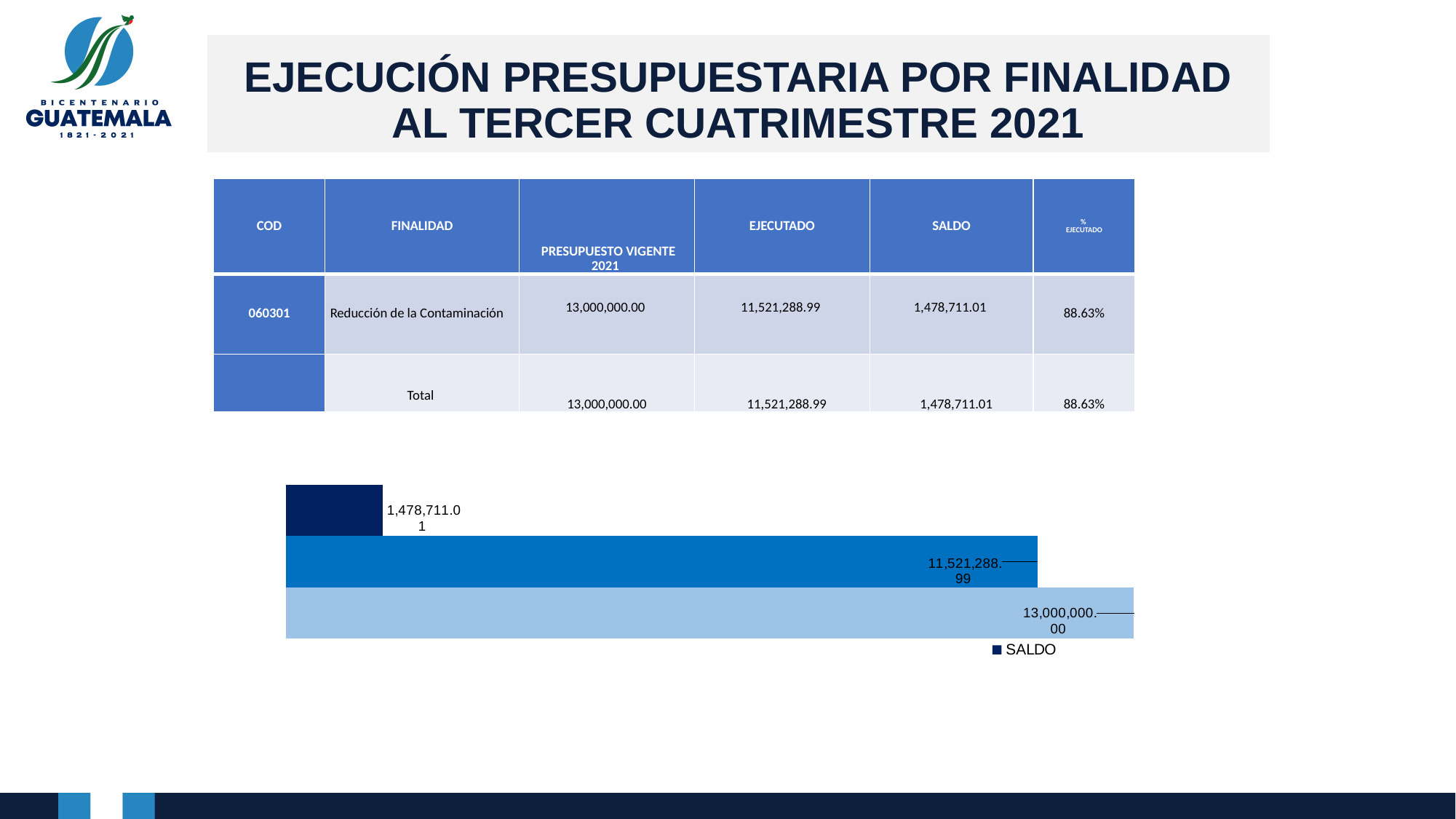
How many bars are plotted in the chart? 3 What kind of chart is shown on the slide? bar chart Which bar in the chart has the lowest value? the top (dark navy) bar, 1,478,711.01 Which bar in the chart has the highest value? the bottom (light blue) bar, 13,000,000.00 What is the difference between the bottom bar value (13,000,000.00) and the middle bar value (11,521,288.99)? 1,478,711.01 What value is labelled on the bottom (light blue) bar of the chart? 13,000,000.00 Which is larger, the value of the middle bar or the value of the top bar? the middle bar (11,521,288.99) How many entries does the chart legend list? 1 What value is labelled on the top (dark navy) bar of the chart? 1,478,711.01 What value is labelled on the middle (blue) bar of the chart? 11,521,288.99 Are the bars in the chart drawn horizontally or vertically? horizontally What is the legend entry shown below the chart? SALDO